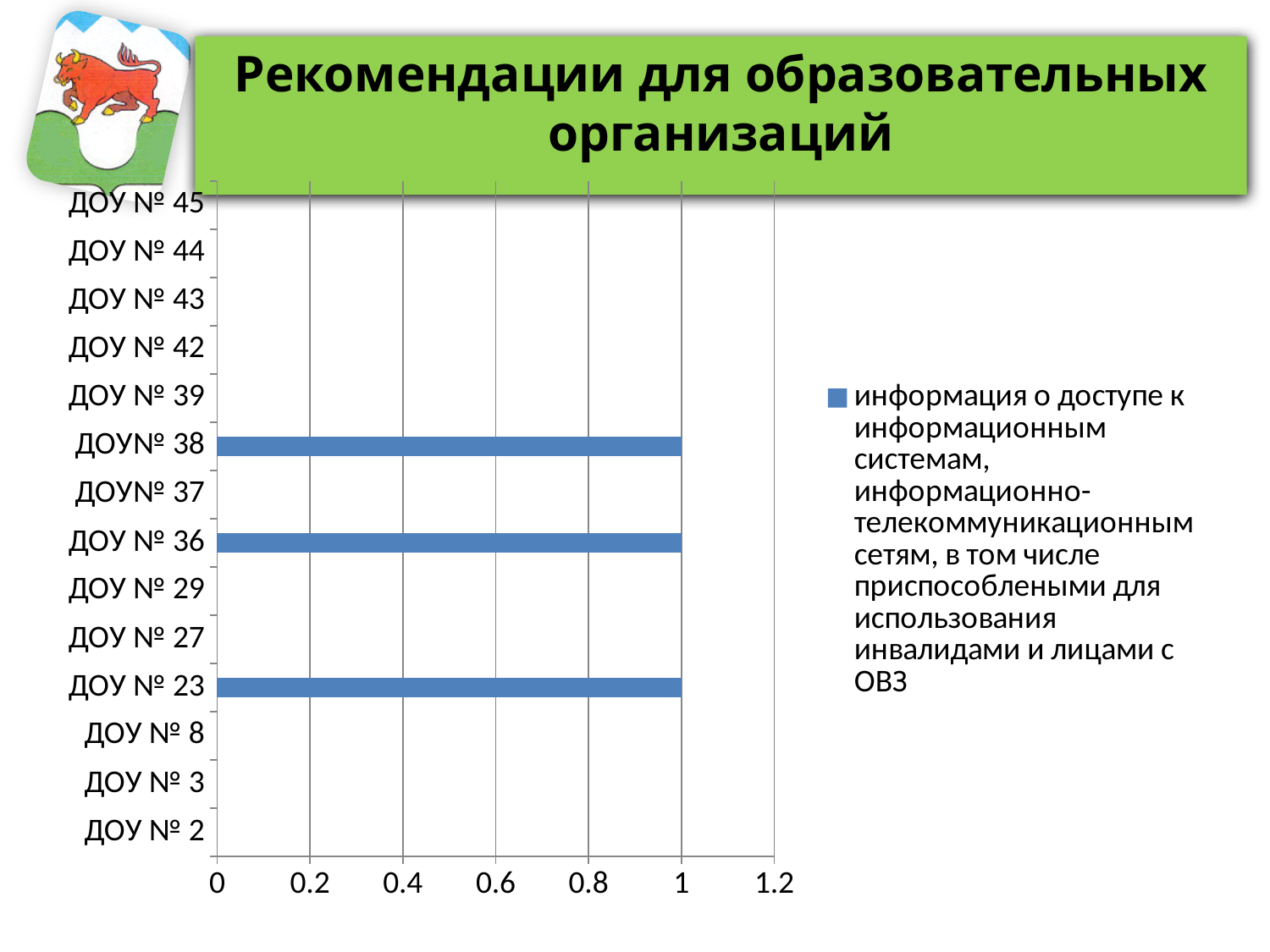
What is the highest value shown on the horizontal axis of the chart? 1.2 Is the value for ДОУ№ 38 greater or less than 0.8? greater Which is larger in the chart, the value for ДОУ № 23 or the value for ДОУ № 8? ДОУ № 23 How many categories in the chart have a visible bar? 3 Which is larger in the chart, the value for ДОУ № 36 or the value for ДОУ № 29? ДОУ № 36 How many categories (ДОУ) are listed on the vertical axis of the chart? 14 What is the value for ДОУ№ 38 in the chart? 1 Is the value for ДОУ № 45 greater or less than 0.2? less How many series does the chart legend list? 1 What type of chart is shown on the slide? bar chart What is the value for ДОУ № 23 in the chart? 1 What is the value for ДОУ № 36 in the chart? 1